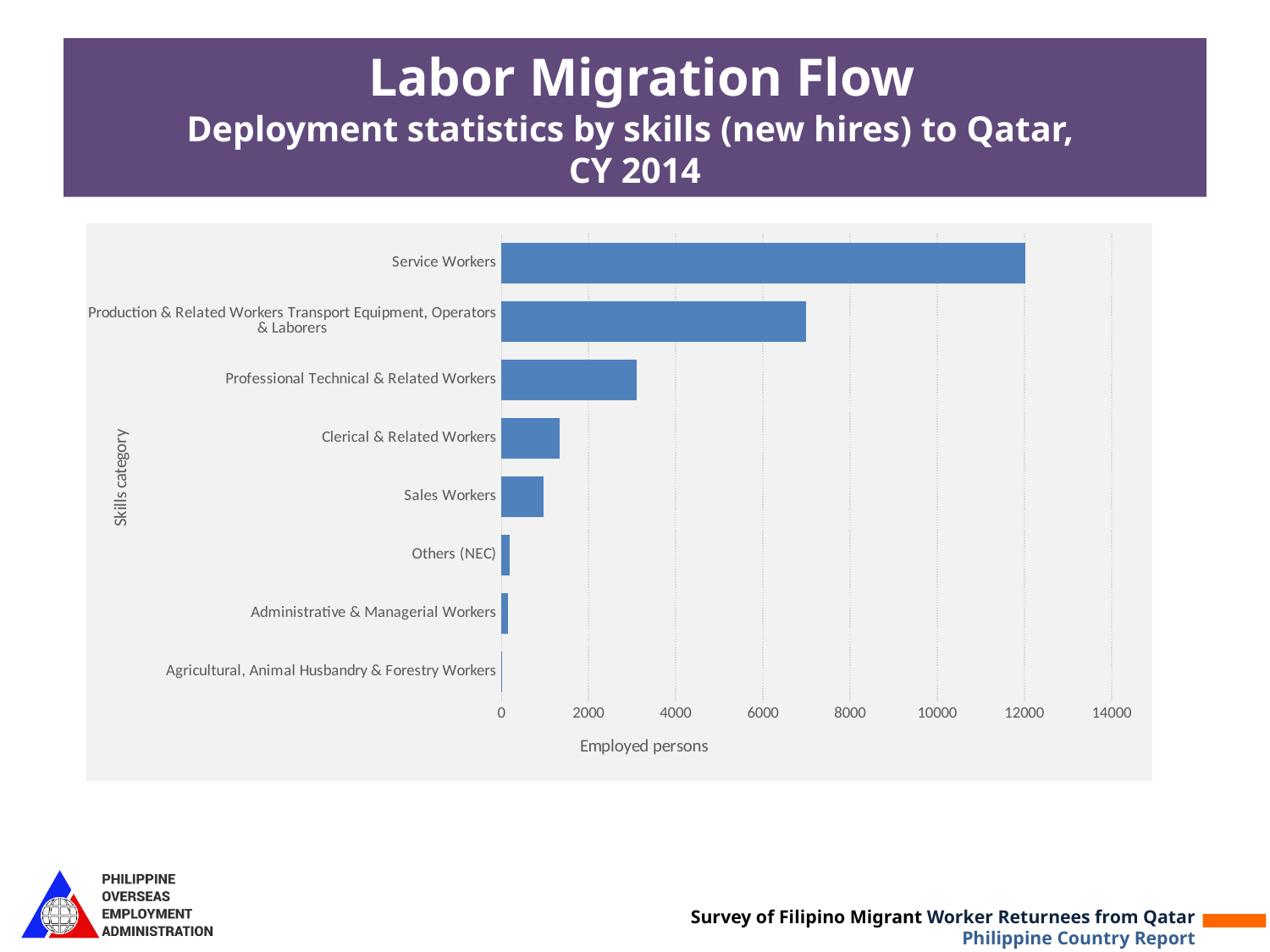
Which has more employed persons: Professional Technical & Related Workers or Production & Related Workers Transport Equipment, Operators & Laborers? Production & Related Workers Transport Equipment, Operators & Laborers What is the label of the horizontal axis of the chart? Employed persons Is the value for Clerical & Related Workers greater or less than 2000? less What kind of chart is shown on the slide? bar chart Is the value for Production & Related Workers Transport Equipment, Operators & Laborers greater or less than 8000? less Which has more employed persons: Sales Workers or Clerical & Related Workers? Clerical & Related Workers Is the value for Professional Technical & Related Workers greater or less than 2000? greater Which skills category has the highest number of employed persons? Service Workers How many skills categories are plotted in the chart? 8 Which skills category has the lowest number of employed persons? Agricultural, Animal Husbandry & Forestry Workers